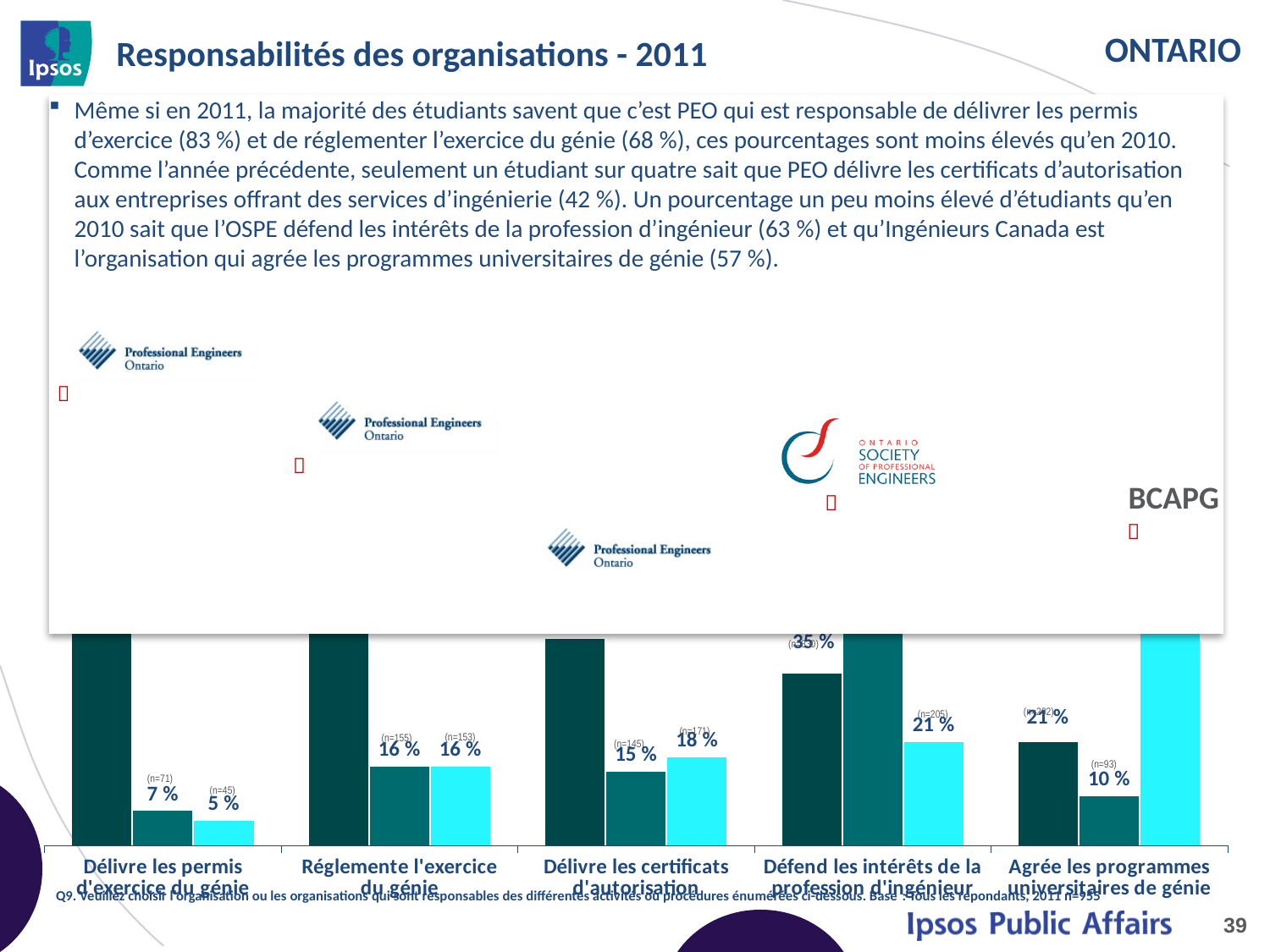
What is the value of the right-hand (cyan) bar for 'Délivre les permis d'exercice du génie'? 5 % For 'Délivre les permis d'exercice du génie', which is larger: the middle bar or the right-hand bar? The middle bar (7 %) How many categories are shown along the x axis of the chart? 5 What kind of chart is shown at the bottom of the slide? Bar chart What is the value of the middle bar for 'Délivre les certificats d'autorisation'? 15 % What is the value of the middle bar for 'Délivre les permis d'exercice du génie'? 7 % What is the difference between the right-hand bar (18 %) and the middle bar (15 %) for 'Délivre les certificats d'autorisation'? 3 percentage points What is the title of the slide containing the chart? Responsabilités des organisations - 2011 What is the value of the right-hand (cyan) bar for 'Défend les intérêts de la profession d'ingénieur'? 21 % What is the value of the middle bar for 'Réglemente l'exercice du génie'? 16 % What is the value of the middle bar for 'Agrée les programmes universitaires de génie'? 10 % What is the value of the right-hand (cyan) bar for 'Délivre les certificats d'autorisation'? 18 %